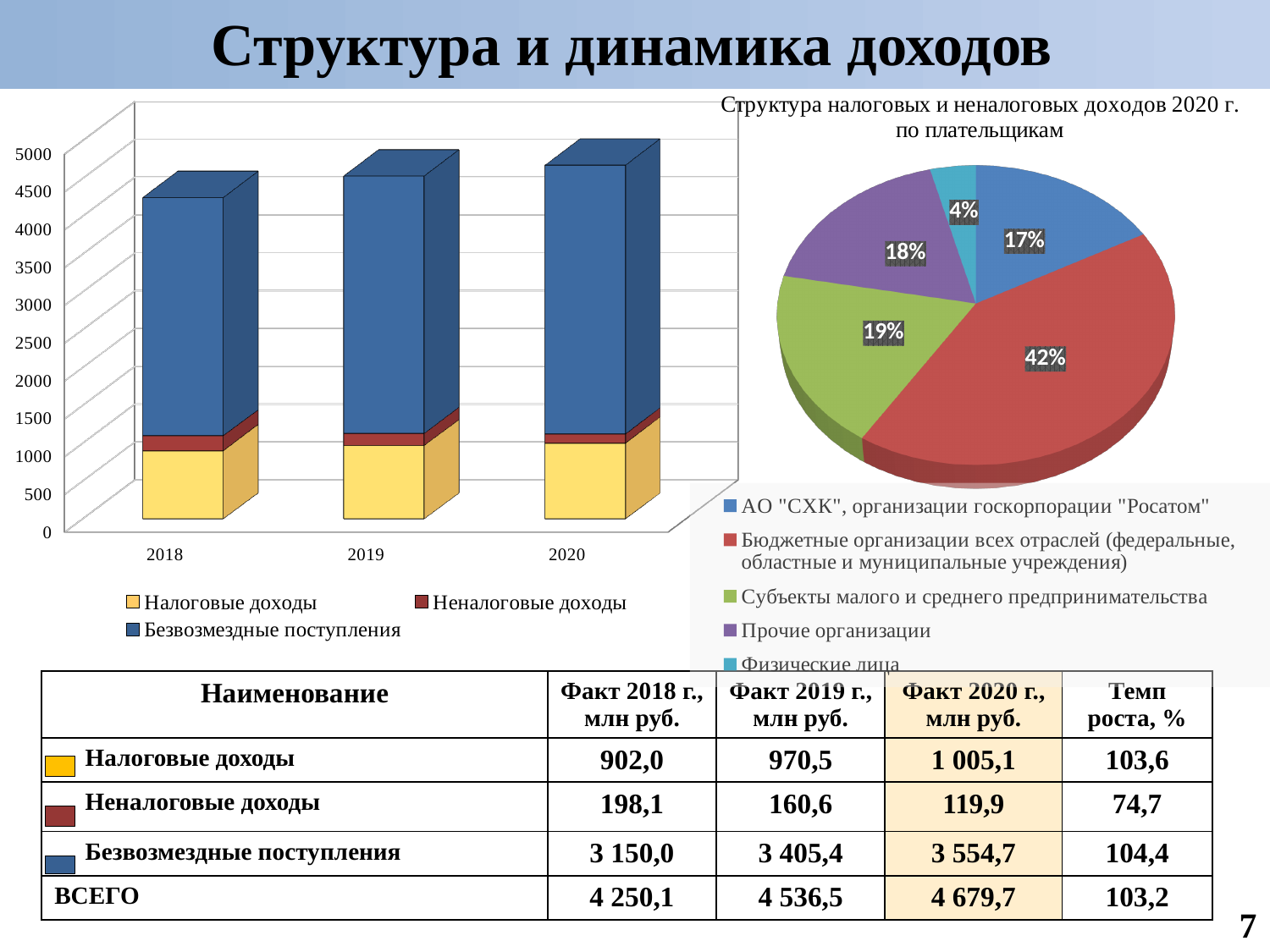
In the pie chart 'Структура налоговых и неналоговых доходов 2020 г. по плательщикам', what share is shown for Бюджетные организации всех отраслей? 42% What kind of chart is the chart on the left of the slide? Stacked bar chart In the pie chart on the right, what share is shown for АО "СХК", организации госкорпорации "Росатом"? 17% In the pie chart on the right, by how many percentage points does the share of Субъекты малого и среднего предпринимательства exceed that of Прочие организации? 1 percentage point How many years are shown on the x axis of the bar chart on the left? 3 In the bar chart on the left, do the total bar heights rise or fall from 2018 to 2020? rise In the bar chart on the left, which segment is larger in 2018: Безвозмездные поступления or Налоговые доходы? Безвозмездные поступления In the pie chart on the right, which payer category has the smallest share? Физические лица In the pie chart on the right, how many slices are there? 5 In the bar chart on the left, is the total height of the 2020 bar greater or less than 4500? greater How many series does the legend of the bar chart on the left list? 3 In the pie chart on the right, which payer category has the largest share? Бюджетные организации всех отраслей (федеральные, областные и муниципальные учреждения)